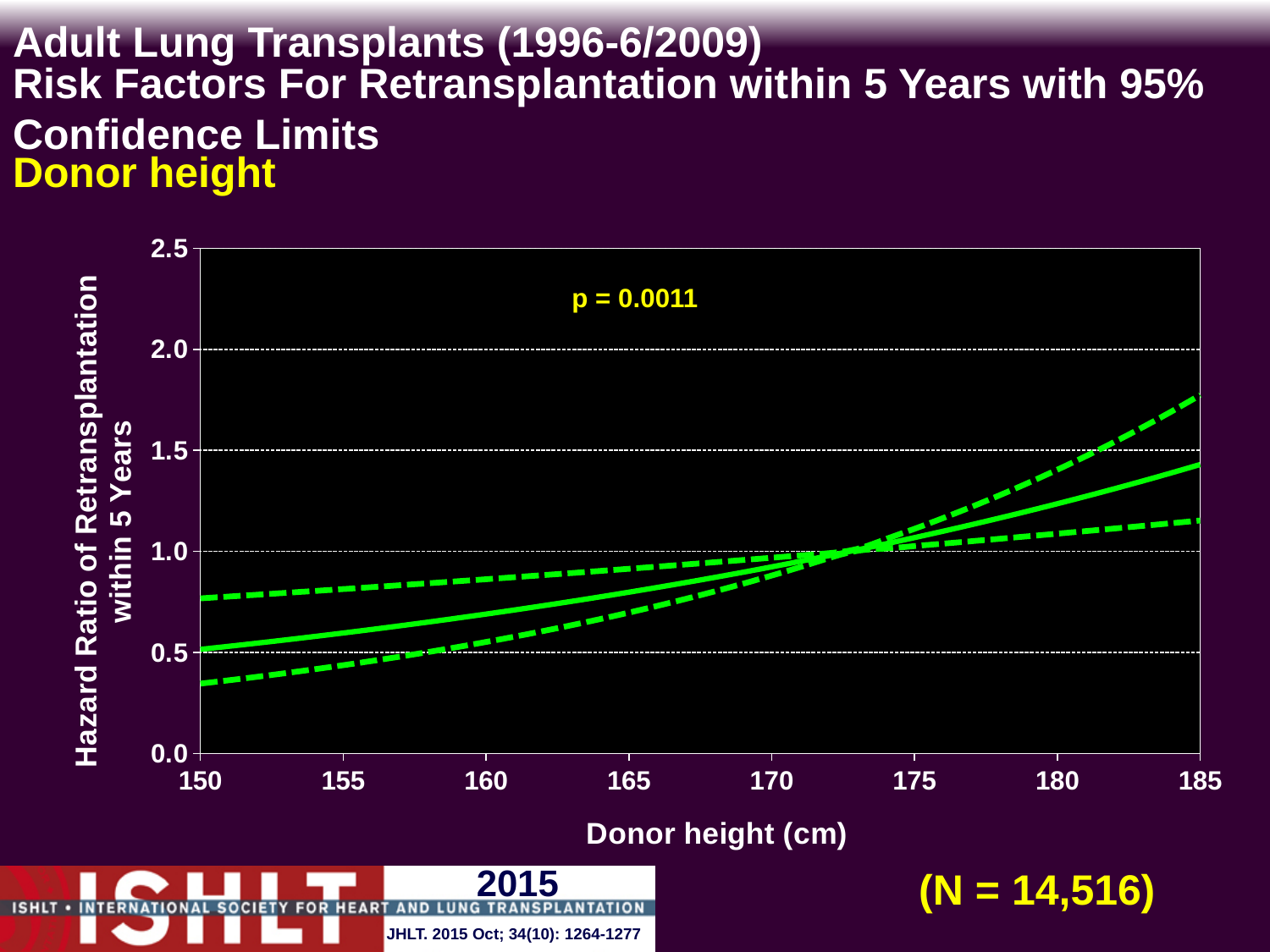
What is the label of the x axis? Donor height (cm) Is the lower confidence limit (lower dashed line) at a donor height of 150 cm greater or less than 0.5? less What p-value is printed on the chart? p = 0.0011 What kind of chart is shown on the slide? line chart Is the hazard ratio (solid line) at a donor height of 160 cm greater or less than 1.0? less How many lines are plotted on the chart? 3 Is the hazard ratio (solid line) at a donor height of 185 cm greater or less than 1.0? greater Does the solid hazard ratio line rise or fall as donor height increases from 150 cm to 185 cm? rise How many tick labels are shown on the x axis? 8